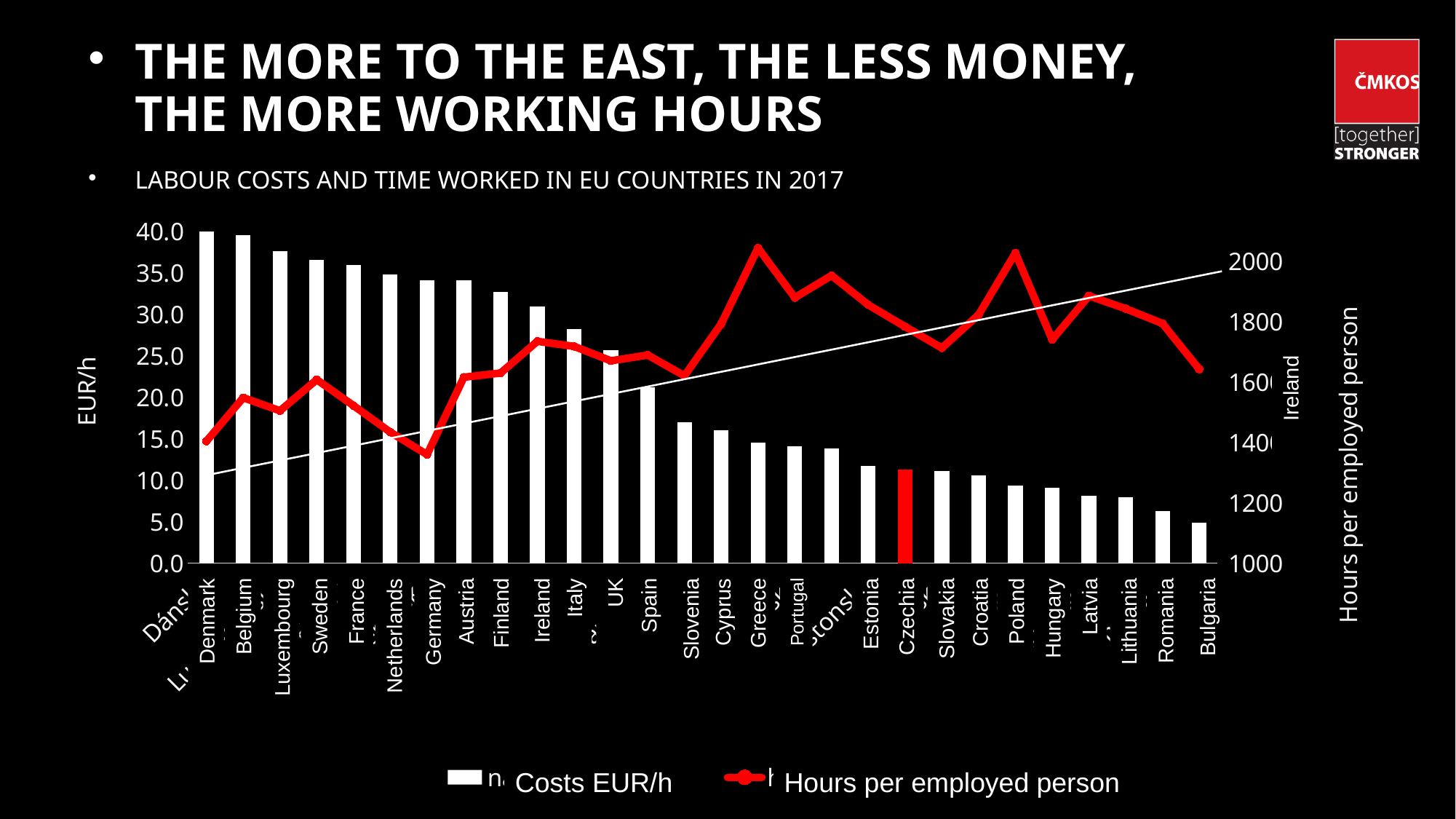
Is the Costs EUR/h value for Spain greater or less than 20.0? greater How many series does the legend list? 2 Is the Costs EUR/h value for Belgium greater or less than 35.0? greater Is the Costs EUR/h value for Czechia greater or less than 10.0? greater Which country's bar is highlighted in red? Czechia Do the Costs EUR/h bars generally rise or fall from left to right across the countries? fall Which country has the highest labour cost (Costs EUR/h) in the chart? Denmark Which country has a higher Costs EUR/h value, Germany or Spain? Germany Which country has the lowest labour cost (Costs EUR/h) in the chart? Bulgaria